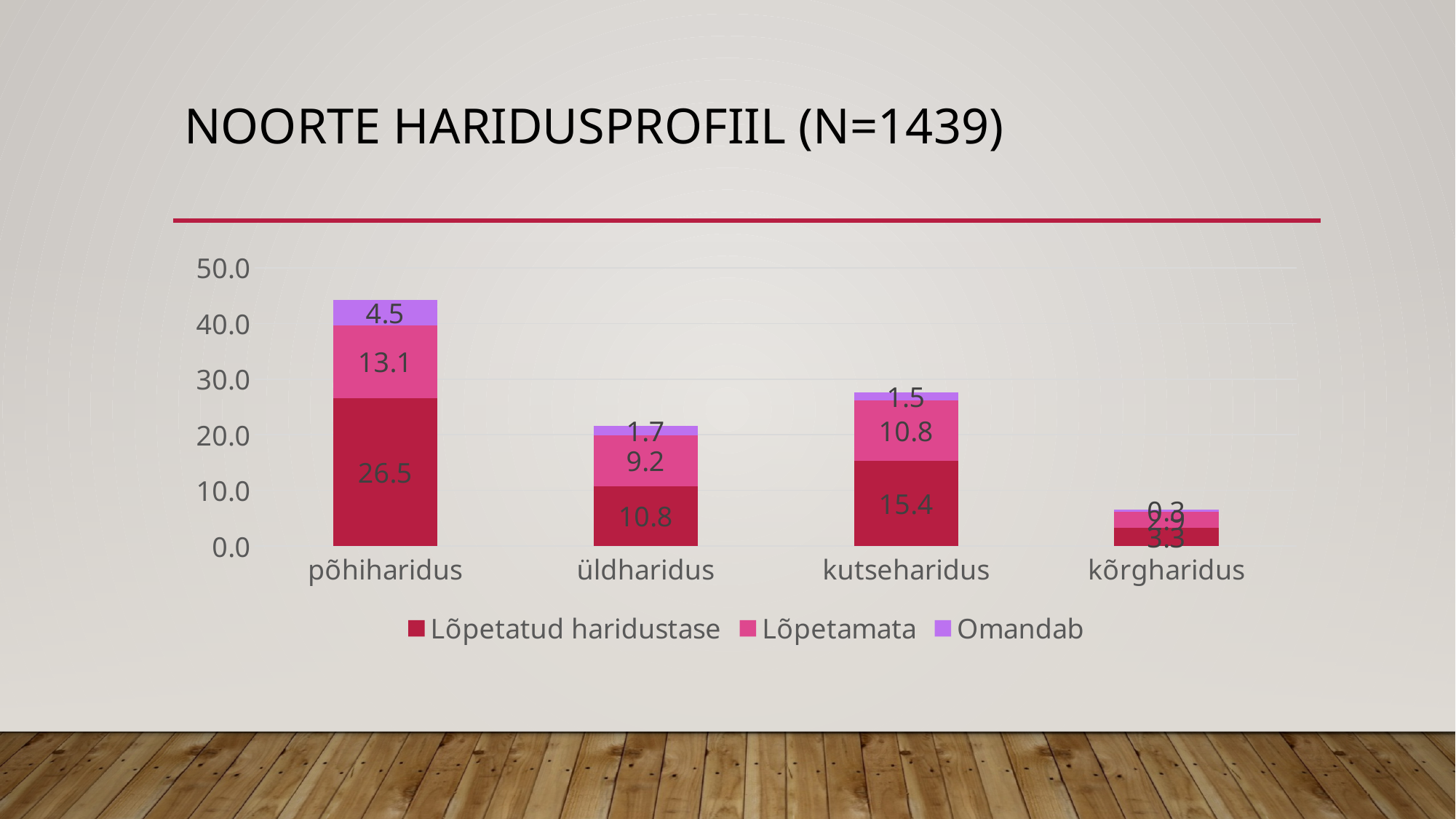
Which category has the lowest total stacked bar? kõrgharidus What is the difference between the Lõpetatud haridustase values for põhiharidus and kutseharidus? 11.1 How many series does the legend list? 3 What kind of chart is shown on the slide? stacked bar chart What is the total of the stacked bar for kutseharidus? 27.7 What is the value of Omandab for üldharidus? 1.7 What is the value of Lõpetamata for kutseharidus? 10.8 How many categories are shown on the x axis? 4 Which has the larger Lõpetamata value, põhiharidus or üldharidus? põhiharidus What is the value of Lõpetatud haridustase for põhiharidus? 26.5 Is the total stacked bar for põhiharidus greater or less than 40.0? greater Which category has the highest value for Lõpetatud haridustase? põhiharidus